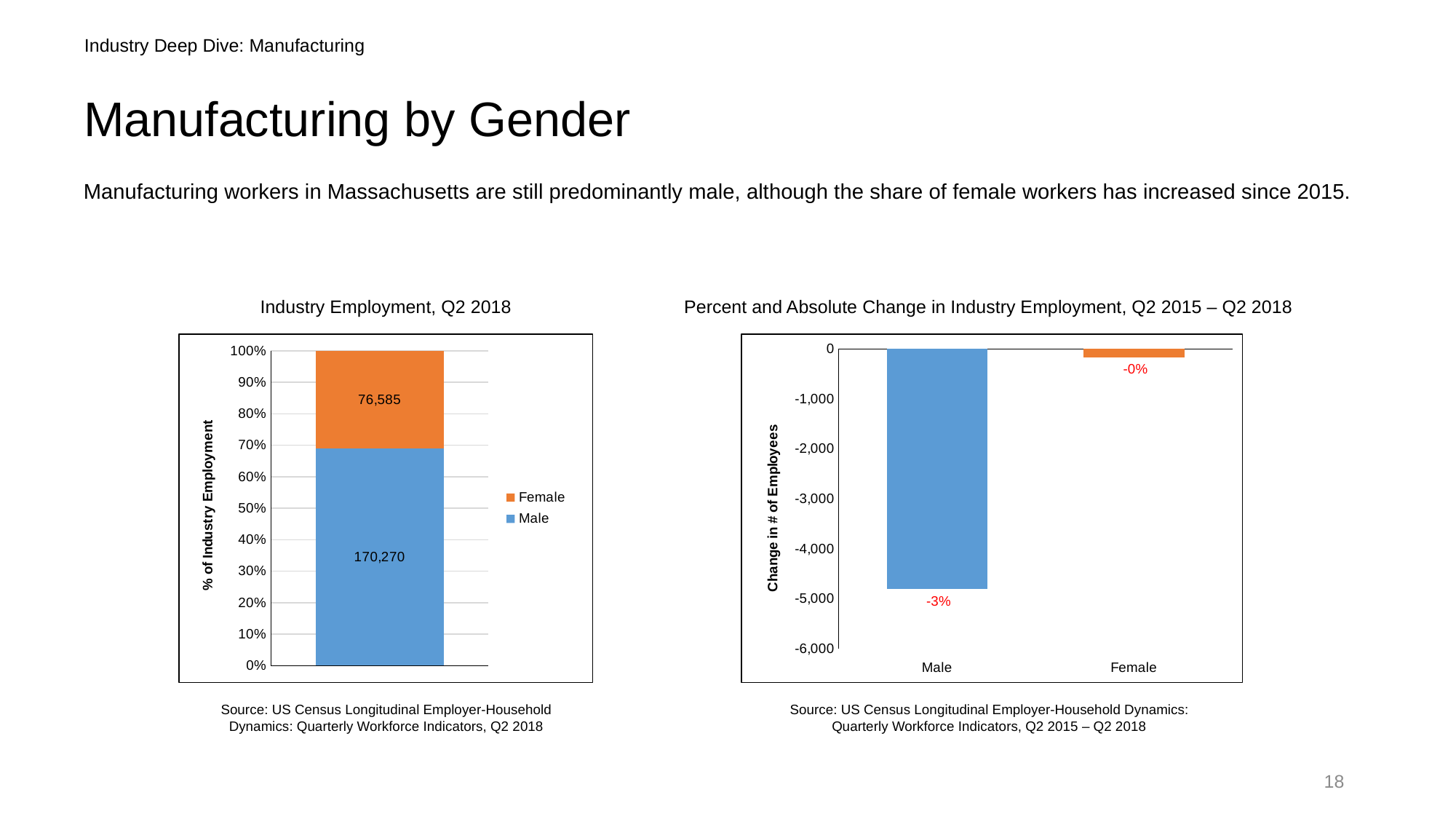
In the 'Percent and Absolute Change in Industry Employment, Q2 2015 – Q2 2018' chart, what percent change is shown for Male? -3% In the 'Industry Employment, Q2 2018' chart, what is the value for Female? 76,585 In the 'Industry Employment, Q2 2018' chart, what is the total of the stacked bar? 246,855 In the 'Industry Employment, Q2 2018' chart, what is the difference between the Male and Female values? 93,685 In the 'Industry Employment, Q2 2018' chart, which is larger, Male or Female? Male In the 'Industry Employment, Q2 2018' chart, what is the value for Male? 170,270 How many categories are shown on the x axis of the 'Percent and Absolute Change in Industry Employment, Q2 2015 – Q2 2018' chart? 2 In the 'Percent and Absolute Change in Industry Employment, Q2 2015 – Q2 2018' chart, what percent change is shown for Female? -0% How many series does the legend of the 'Industry Employment, Q2 2018' chart list? 2 What is the y-axis title of the 'Percent and Absolute Change in Industry Employment, Q2 2015 – Q2 2018' chart? Change in # of Employees What kind of chart is the 'Industry Employment, Q2 2018' chart? Stacked bar chart In the 'Percent and Absolute Change in Industry Employment, Q2 2015 – Q2 2018' chart, is the value for Male greater or less than -4,000? less